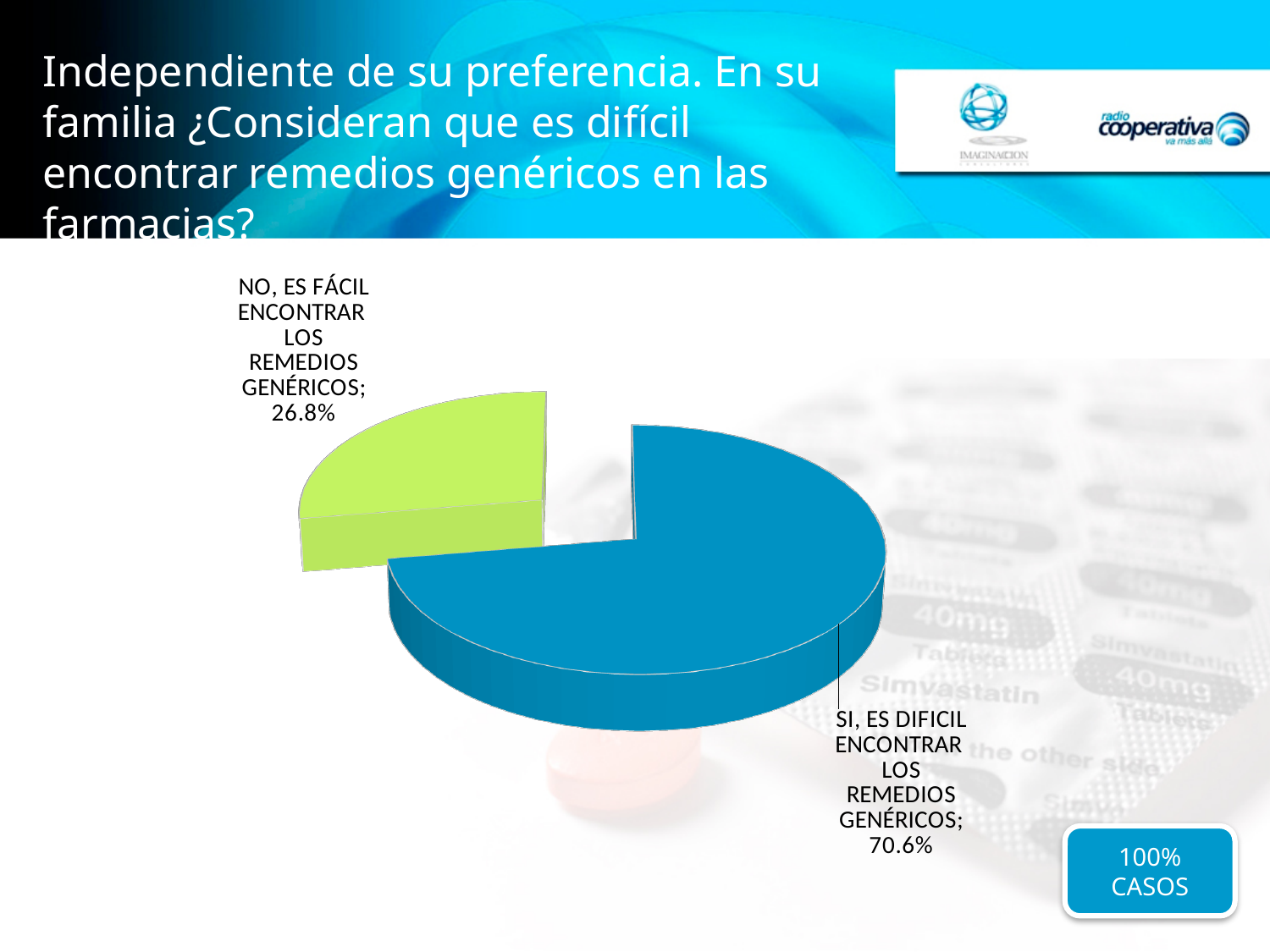
What colour is the slice for "SI, ES DIFICIL ENCONTRAR LOS REMEDIOS GENÉRICOS"? Blue What percentage is shown for "SI, ES DIFICIL ENCONTRAR LOS REMEDIOS GENÉRICOS"? 70.6% Which is larger: the share for "SI, ES DIFICIL ENCONTRAR LOS REMEDIOS GENÉRICOS" or for "NO, ES FÁCIL ENCONTRAR LOS REMEDIOS GENÉRICOS"? SI, ES DIFICIL ENCONTRAR LOS REMEDIOS GENÉRICOS Which slice of the pie is the largest? SI, ES DIFICIL ENCONTRAR LOS REMEDIOS GENÉRICOS Is the share for "NO, ES FÁCIL ENCONTRAR LOS REMEDIOS GENÉRICOS" greater or less than 50%? less Which slice of the pie is the smallest? NO, ES FÁCIL ENCONTRAR LOS REMEDIOS GENÉRICOS What is the difference in percentage points between the "SI, ES DIFICIL" slice and the "NO, ES FÁCIL" slice? 43.8 What kind of chart is shown on the slide? Pie chart Is the share for "SI, ES DIFICIL ENCONTRAR LOS REMEDIOS GENÉRICOS" greater or less than 50%? greater What percentage is shown for "NO, ES FÁCIL ENCONTRAR LOS REMEDIOS GENÉRICOS"? 26.8% What colour is the slice for "NO, ES FÁCIL ENCONTRAR LOS REMEDIOS GENÉRICOS"? Green How many labelled slices does the pie chart have? 2